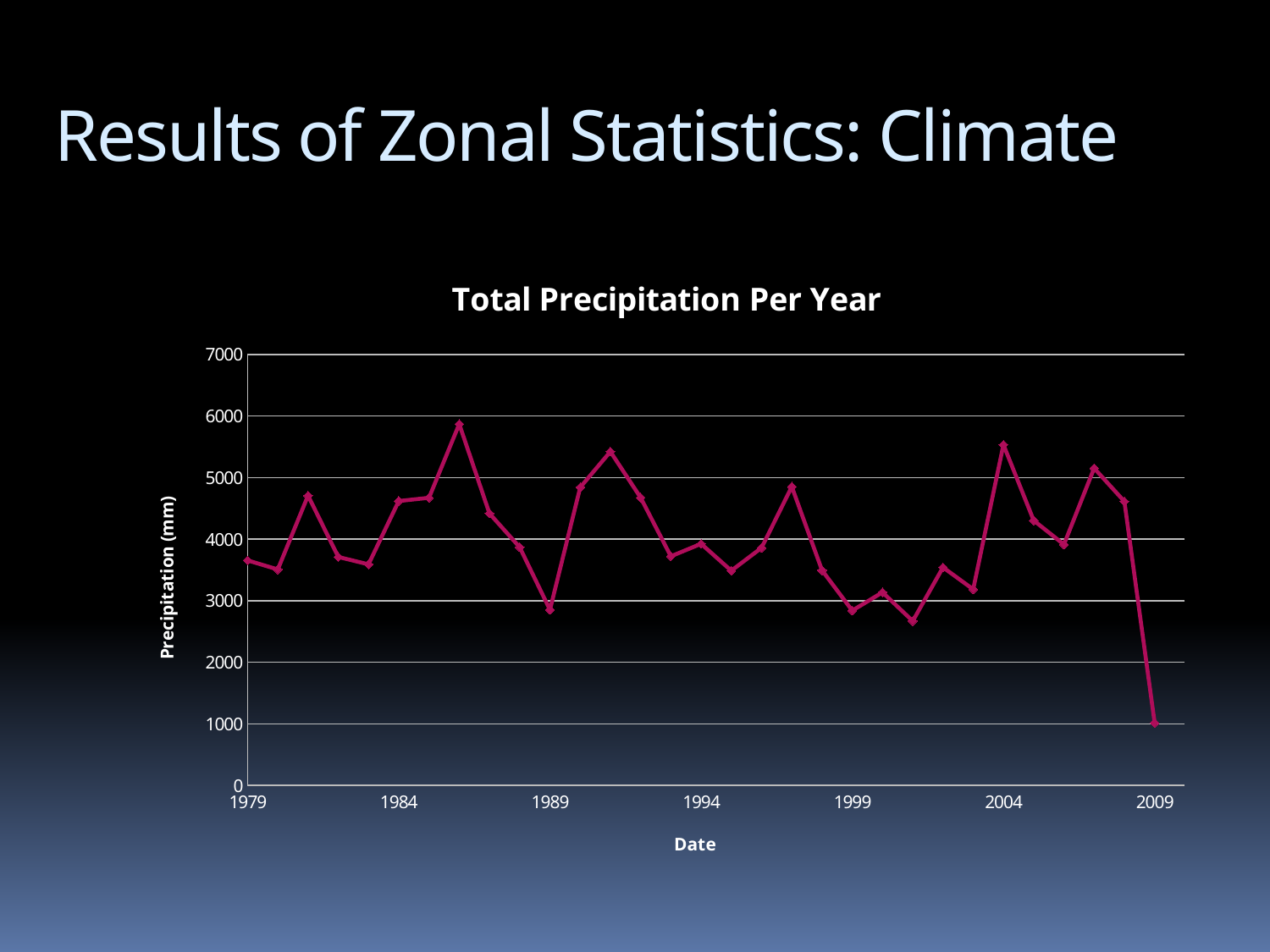
Which has the larger precipitation value, 2004 or 2009? 2004 Does the precipitation value rise or fall from 2004 to 2009? fall Which has the larger precipitation value, 1984 or 1989? 1984 What is the label on the vertical axis of the chart? Precipitation (mm) What is the title of the chart? Total Precipitation Per Year Is the value for 2009 greater or less than 2000? less Which labeled year on the x axis has the lowest precipitation value? 2009 Is the value for 1984 greater or less than 4000? greater What type of chart is shown on the slide? line chart Is the value for 1979 greater or less than 3000? greater